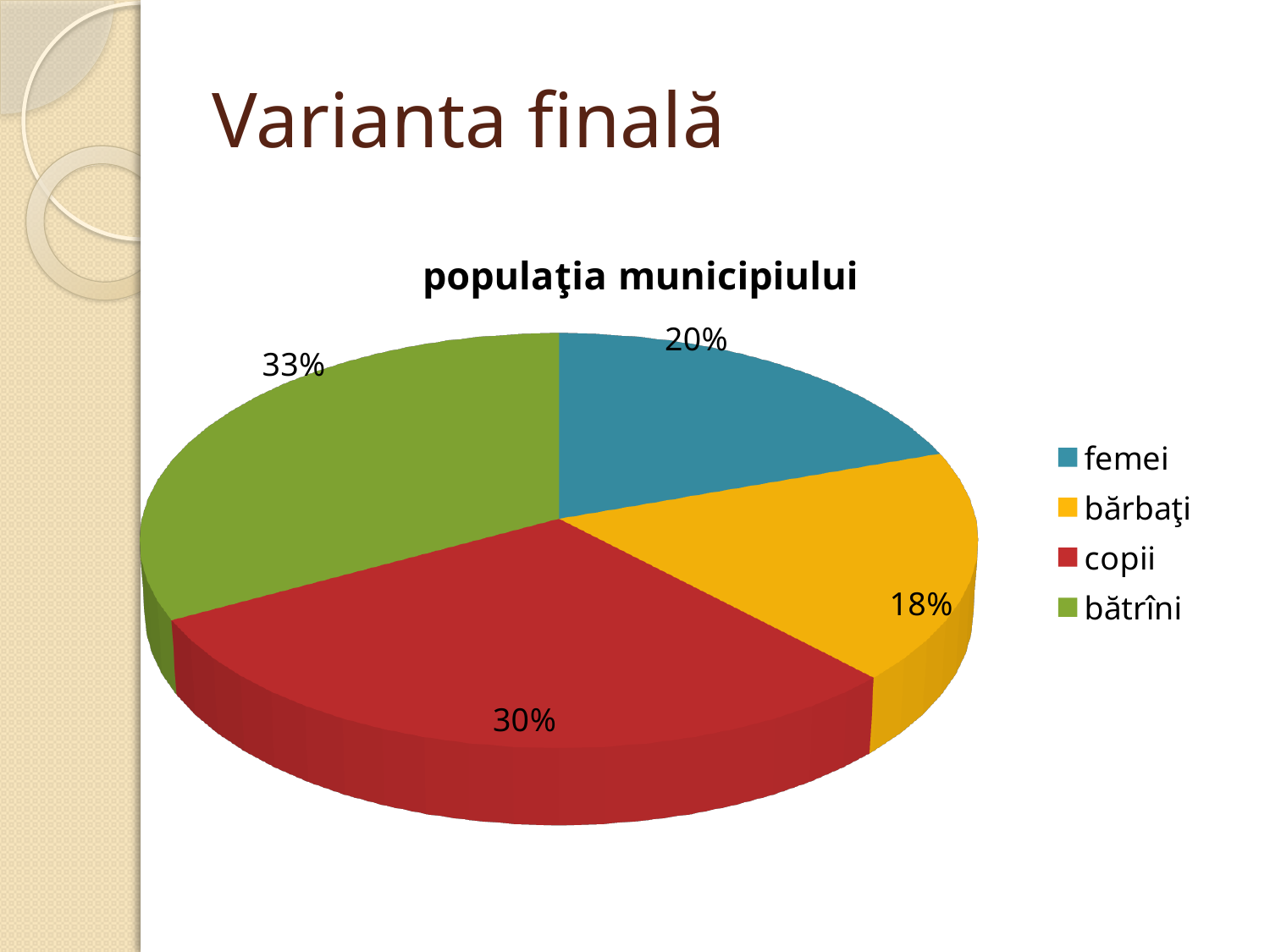
What colour is the copii slice? red What is the difference in percentage points between the copii slice and the femei slice? 10 What share of the pie does copii have? 30% Which slice is larger, femei or bărbaţi? femei Which category has the largest slice of the pie? bătrîni How many categories does the pie chart show? 4 What is the title of the chart? populaţia municipiului What share of the pie does femei have? 20% What kind of chart is shown on the slide? pie chart What share of the pie does bătrîni have? 33% Which category has the smallest slice of the pie? bărbaţi